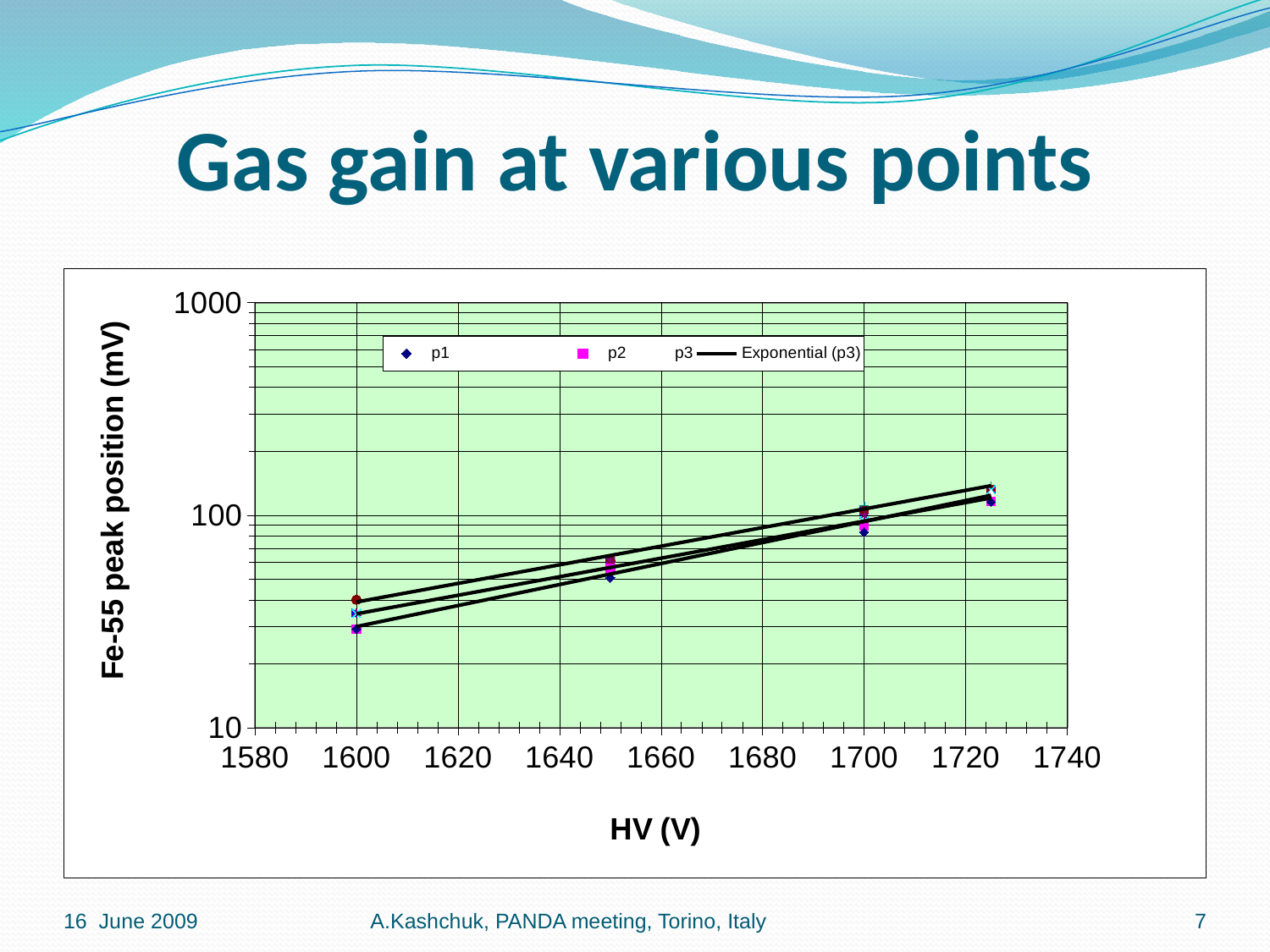
Is the value for p2 at HV 1600 greater or less than 10? greater What is the title of the chart's x axis? HV (V) What is the title of the chart's y axis? Fe-55 peak position (mV) What kind of chart is shown on the slide? scatter chart Is the value for p2 at HV 1650 greater or less than 100? less Is the value for p3 at HV 1725 greater or less than 100? greater Which is larger for p1: the value at HV 1600 or the value at HV 1700? 1700 How many entries does the chart legend list? 4 At which HV value is the Fe-55 peak position highest? 1725 At how many HV values are data points plotted? 4 Do the Fe-55 peak position values rise or fall as HV increases? rise